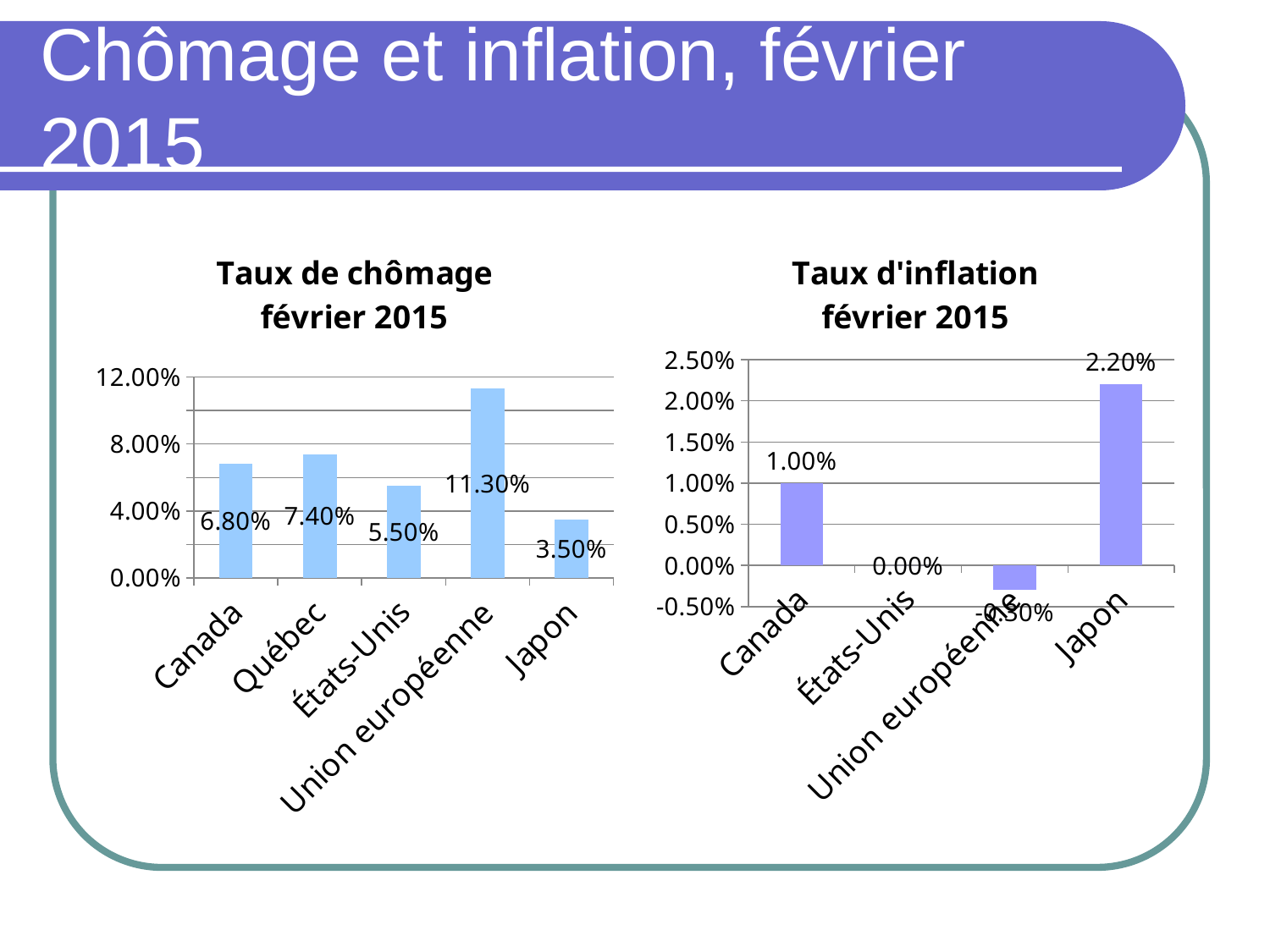
In the 'Taux de chômage février 2015' chart, which category has the lowest value? Japon In the 'Taux de chômage février 2015' chart, what is the unemployment rate for Canada? 6.80% How many categories are shown in the 'Taux de chômage février 2015' chart? 5 In the 'Taux d'inflation février 2015' chart, is the value for Union européenne greater or less than 0.00%? less In the 'Taux d'inflation février 2015' chart, what is the inflation rate for Japon? 2.20% In the 'Taux de chômage février 2015' chart, what is the value for Union européenne? 11.30% In the 'Taux d'inflation février 2015' chart, what is the value for États-Unis? 0.00% In the 'Taux de chômage février 2015' chart, which is larger, the value for Canada or the value for Québec? Québec In the 'Taux de chômage février 2015' chart, which category has the highest value? Union européenne In the 'Taux de chômage février 2015' chart, what is the difference between the values for Québec and États-Unis? 1.90% What type of chart is the 'Taux d'inflation février 2015' chart? bar chart In the 'Taux d'inflation février 2015' chart, what is the difference between the values for Japon and Canada? 1.20%